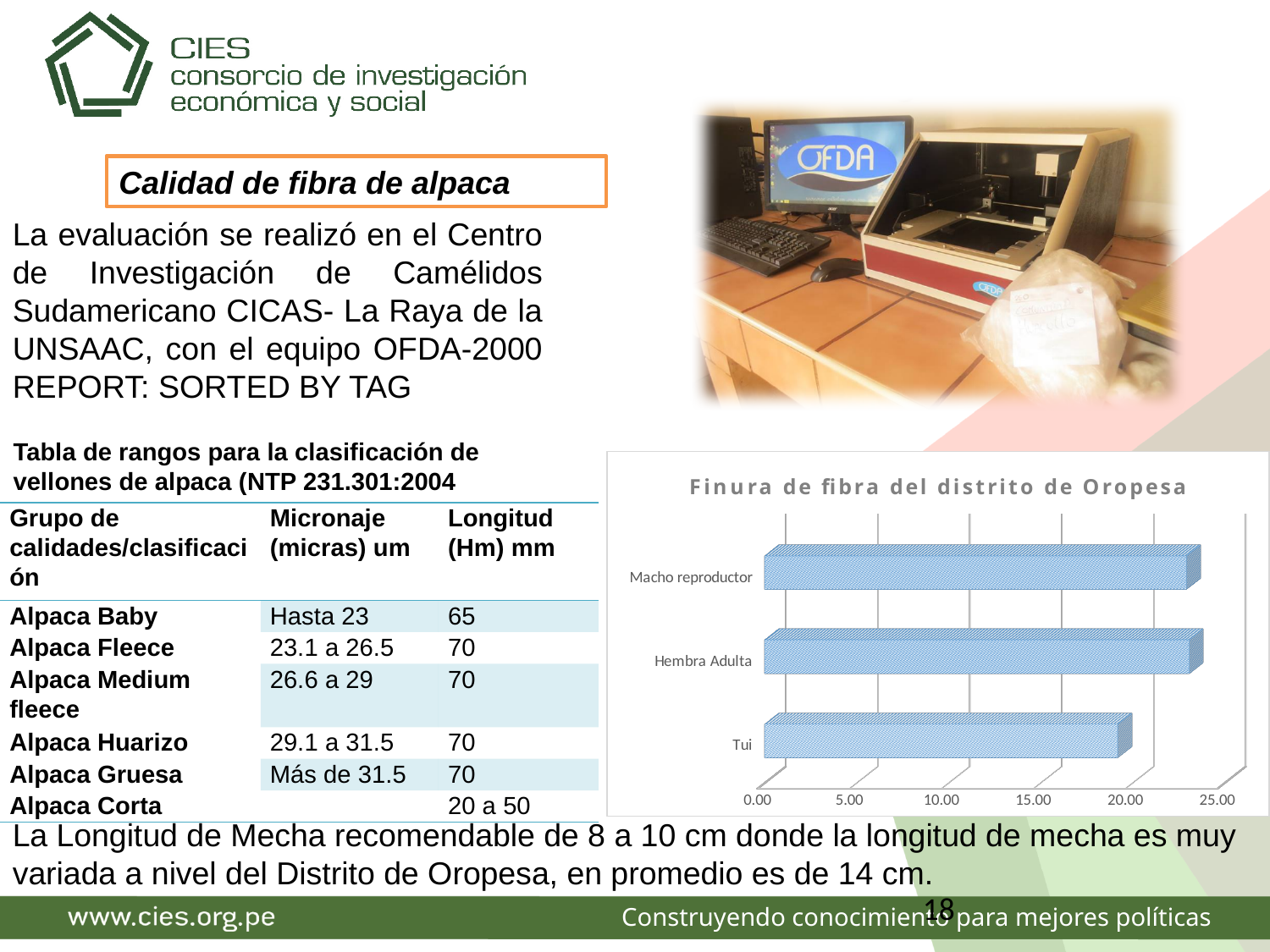
Is the value for Macho reproductor greater or less than 25.00? less How many categories are plotted in the chart? 3 Is the value for Macho reproductor greater or less than 20.00? greater What is the highest tick value shown on the horizontal axis of the chart? 25.00 Is the value for Tui greater or less than 25.00? less Which is larger, the value for Macho reproductor or the value for Tui? Macho reproductor Which is larger, the value for Hembra Adulta or the value for Tui? Hembra Adulta What is the title of the chart? Finura de fibra del distrito de Oropesa What kind of chart is shown on the slide? bar chart Which category has the lowest value in the chart? Tui